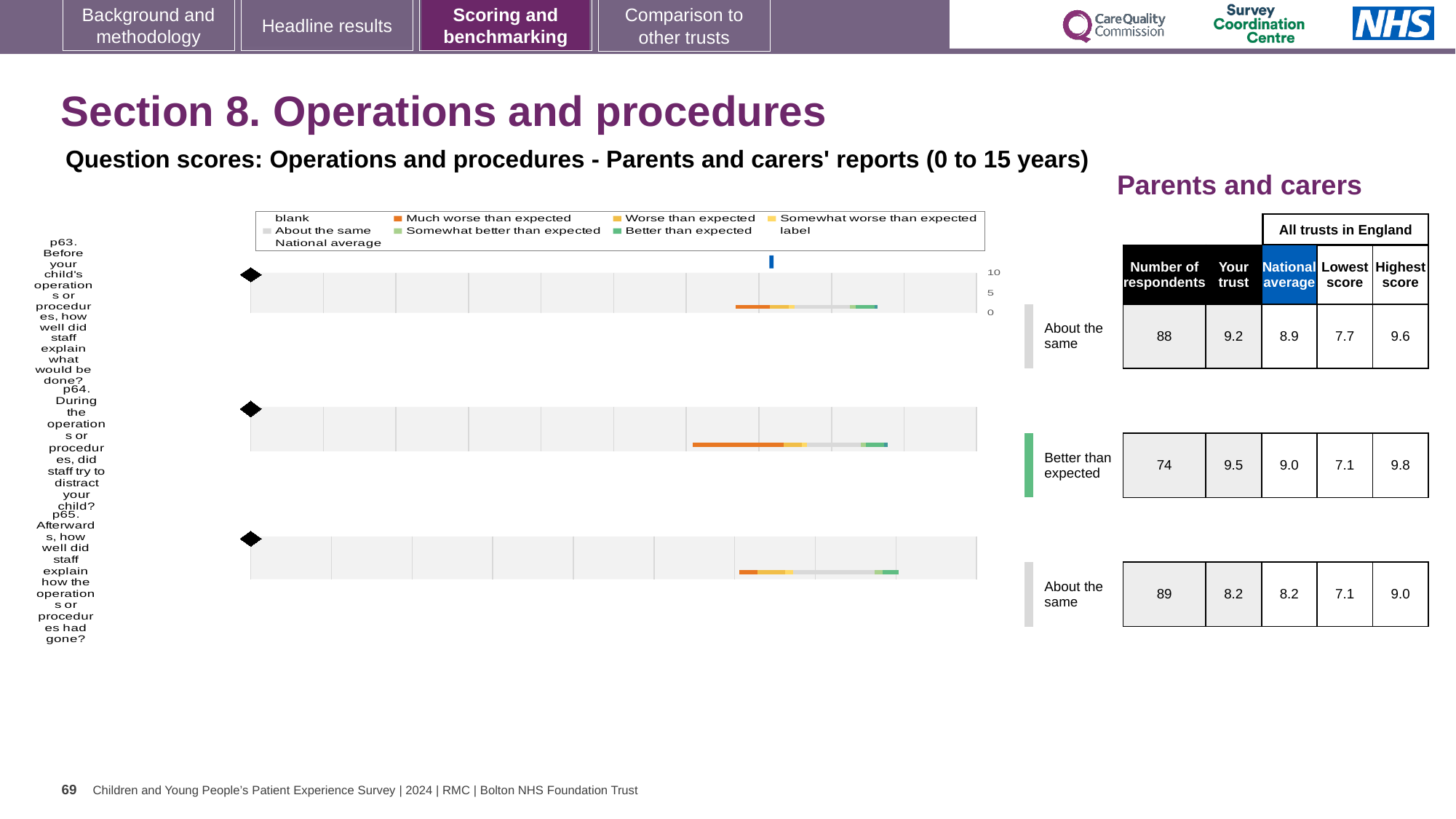
What is the national average score for p65 (Afterwards, how well did staff explain how the operations or procedures had gone?)? 8.2 For p63, which is larger: the 'Your trust' score or the national average? Your trust What is the 'Your trust' score for p63 (Before your child's operations or procedures, how well did staff explain what would be done?)? 9.2 What kind of chart is used to show the question scores on this slide? bar chart How many respondents answered p64? 74 Is the 'Your trust' score for p63 greater or less than 5? greater What is the difference between the 'Your trust' score and the national average for p64? 0.5 Which question has the lowest 'Your trust' score? p65 What is the 'Your trust' score for p64 (During the operations or procedures, did staff try to distract your child?)? 9.5 Which question has the highest 'Your trust' score? p64 How many questions (p63, p64, p65) are plotted on the slide? 3 What benchmark category is shown for p64? Better than expected